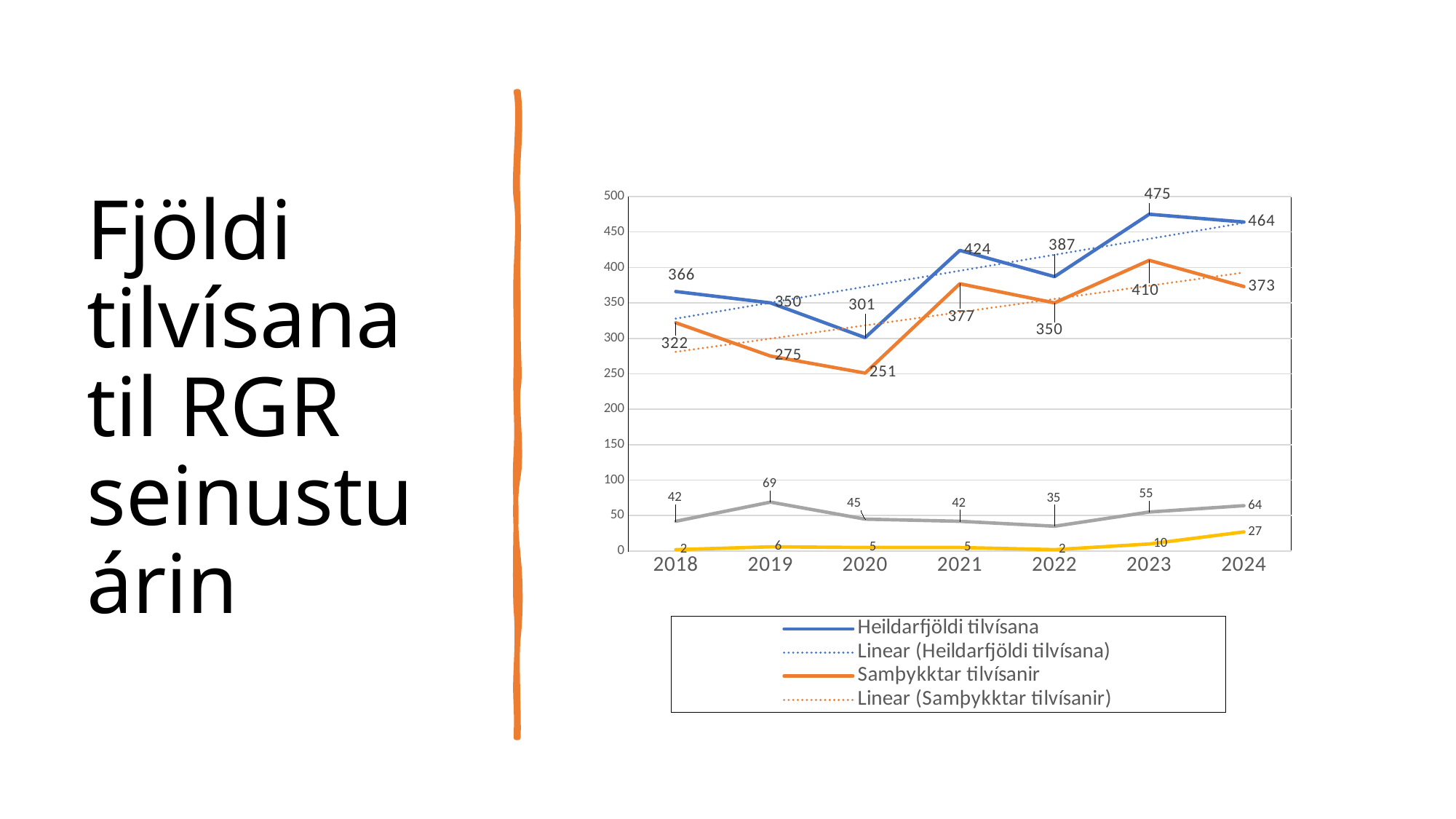
Which year has the larger value for Heildarfjöldi tilvísana, 2019 or 2020? 2019 What kind of chart is shown on the slide? Line chart In which year is Heildarfjöldi tilvísana highest? 2023 How many entries does the legend list? 4 What is the value of Heildarfjöldi tilvísana in 2021? 424 In which year is Samþykktar tilvísanir lowest? 2020 What is the value of Samþykktar tilvísanir in 2020? 251 Which legend entry corresponds to the dotted blue line? Linear (Heildarfjöldi tilvísana) What is the difference between Heildarfjöldi tilvísana and Samþykktar tilvísanir in 2024? 91 Does Samþykktar tilvísanir rise or fall from 2020 to 2023? Rise What is the value of Heildarfjöldi tilvísana in 2018? 366 How many years are shown on the x axis? 7